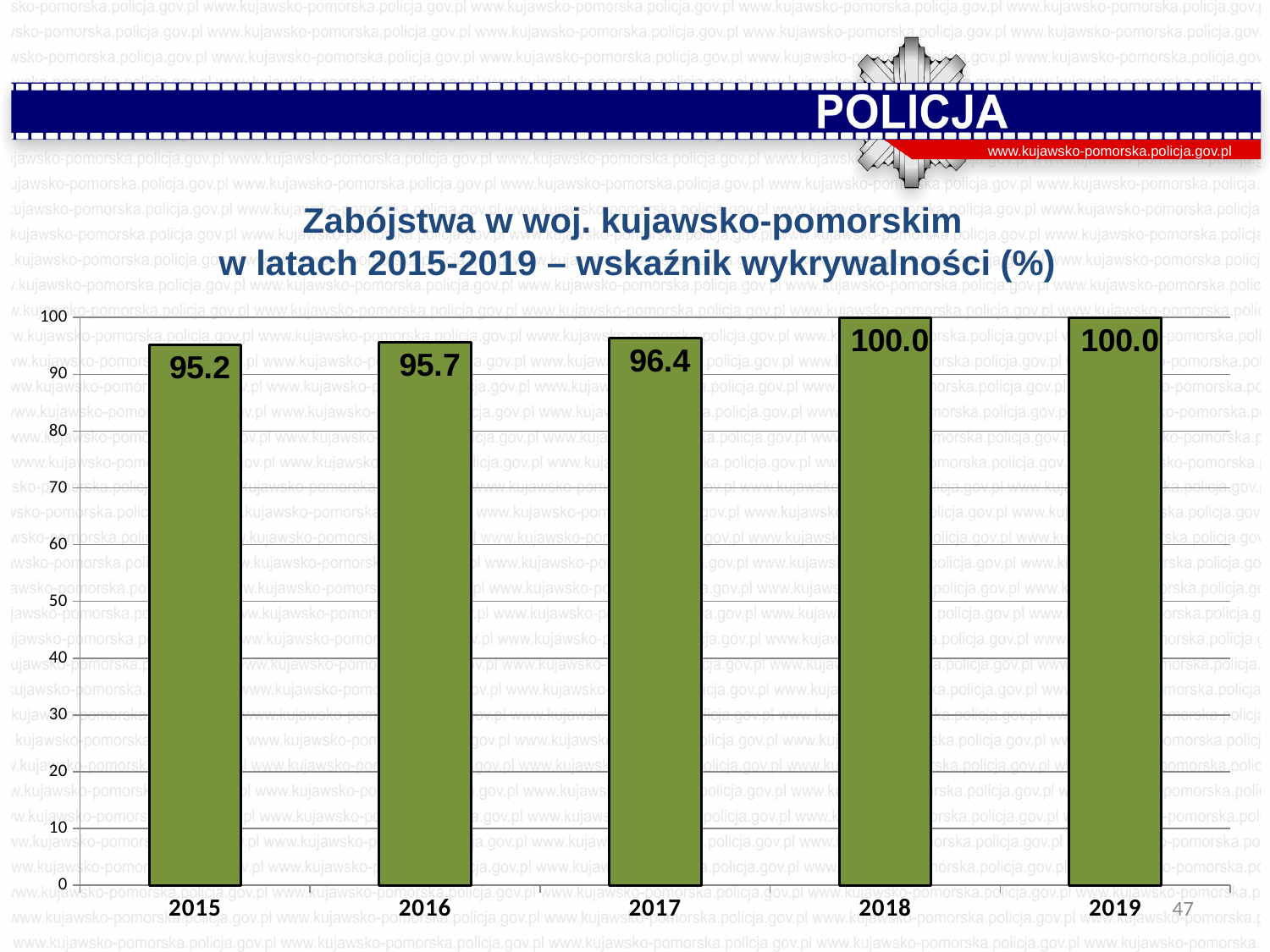
What is the title of the chart? Zabójstwa w woj. kujawsko-pomorskim w latach 2015-2019 – wskaźnik wykrywalności (%) How many years are shown on the x axis? 5 Which is larger, the value for 2016 or the value for 2017? 2017 What kind of chart is shown on the slide? bar chart What is the detection rate value shown for 2019? 100.0 What is the difference between the values for 2018 and 2016? 4.3 What is the difference between the values for 2017 and 2015? 1.2 Is the value for 2016 greater or less than 90? greater What is the detection rate value shown for 2015? 95.2 Do the values rise or fall from 2015 to 2019? rise What is the detection rate value shown for 2017? 96.4 Which year has the lowest detection rate? 2015